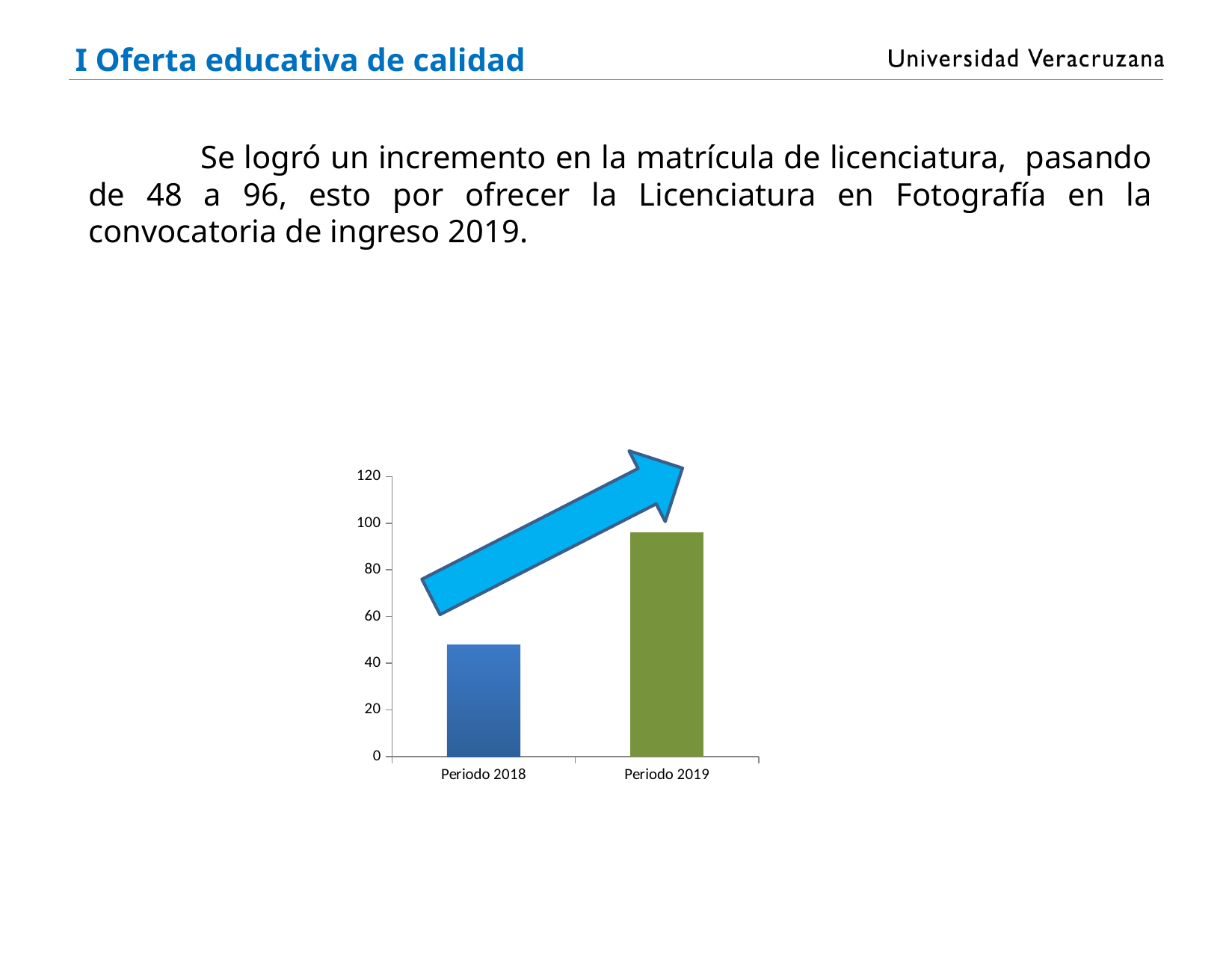
What is the highest value shown on the chart's vertical axis? 120 Is the value for Periodo 2019 greater or less than 100? less How many bars does the chart show? 2 Which period has the lower bar in the chart? Periodo 2018 Which period has the higher bar in the chart? Periodo 2019 What kind of chart is shown on the slide? bar chart Is the value for Periodo 2018 greater or less than 40? greater Is the value for Periodo 2018 greater or less than 60? less Is the bar for Periodo 2018 taller or shorter than the bar for Periodo 2019? shorter What colour is the bar for Periodo 2019? green Do the values rise or fall from Periodo 2018 to Periodo 2019? rise